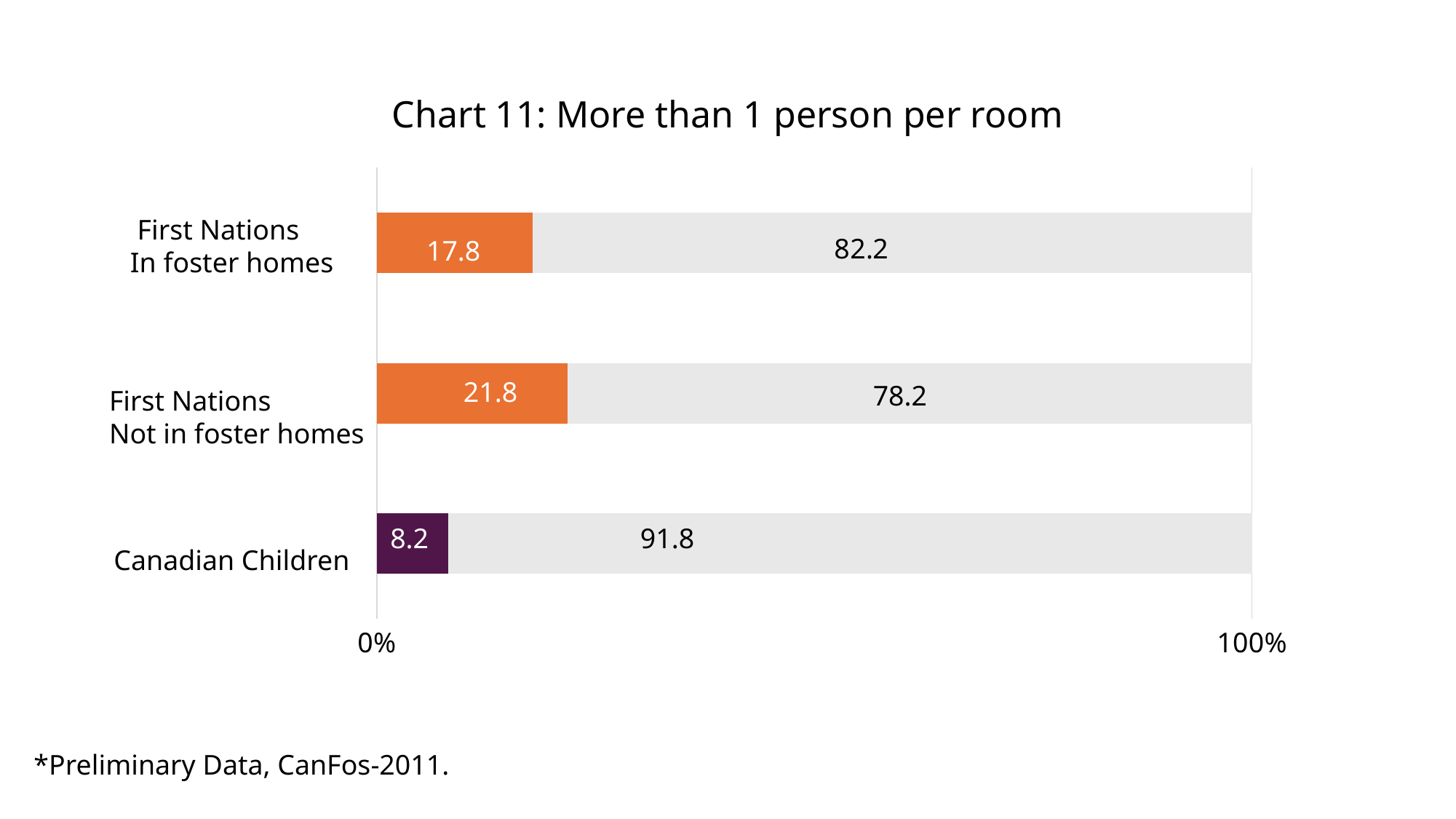
What colour is the first segment of the Canadian Children bar? Purple Which category has the lowest coloured (first) segment value? Canadian Children What is the total of the two segments in the Canadian Children bar? 100 Which is larger: the first segment value for First Nations In foster homes or for Canadian Children? First Nations In foster homes Which category has the highest coloured (first) segment value? First Nations Not in foster homes What is the grey segment value for First Nations Not in foster homes? 78.2 What is the coloured (first) segment value for First Nations In foster homes? 17.8 What is the title of the chart? Chart 11: More than 1 person per room How many categories are shown on the chart? 3 What is the coloured (first) segment value for Canadian Children? 8.2 What is the difference between the first segment values for First Nations Not in foster homes and First Nations In foster homes? 4 What kind of chart is this? Stacked bar chart